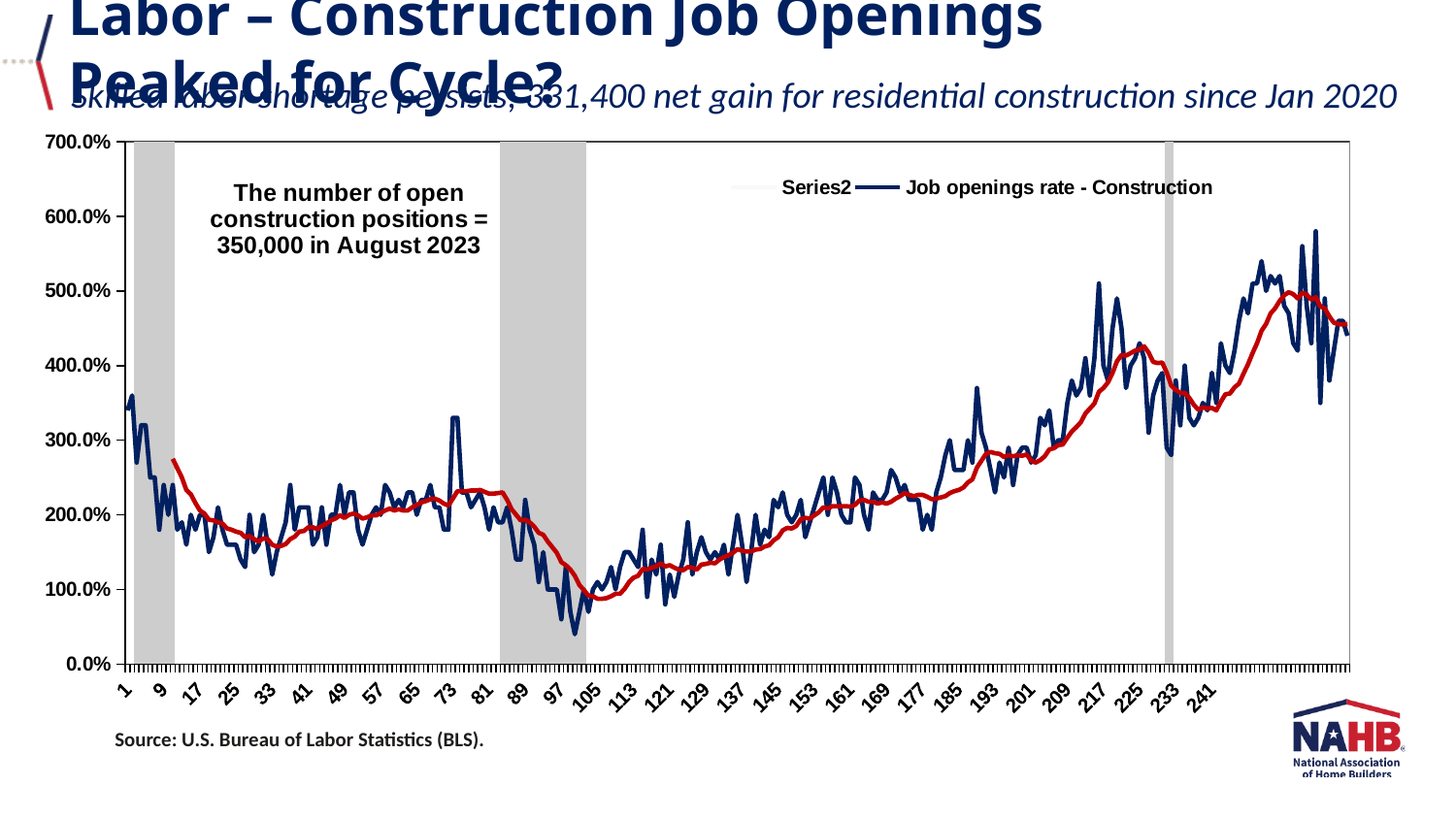
Is the highest peak of the job openings rate for construction, near x = 233 to 241, greater or less than 500.0%? greater Does the job openings rate for construction generally rise or fall between x = 1 and x = 33? Fall Is the lowest point of the job openings rate for construction, near x = 97 to 105, greater or less than 100.0%? less What is the highest value shown on the chart's y axis? 700.0% According to the annotation on the chart, how many open construction positions were there in August 2023? 350,000 Is the job openings rate for construction at x = 1 greater or less than 300.0%? greater Does the job openings rate for construction generally rise or fall between x = 105 and x = 225? Rise What kind of chart is shown on the slide? Line chart How many series does the chart legend list? 2 What is the name of the second series listed in the chart legend? Job openings rate - Construction